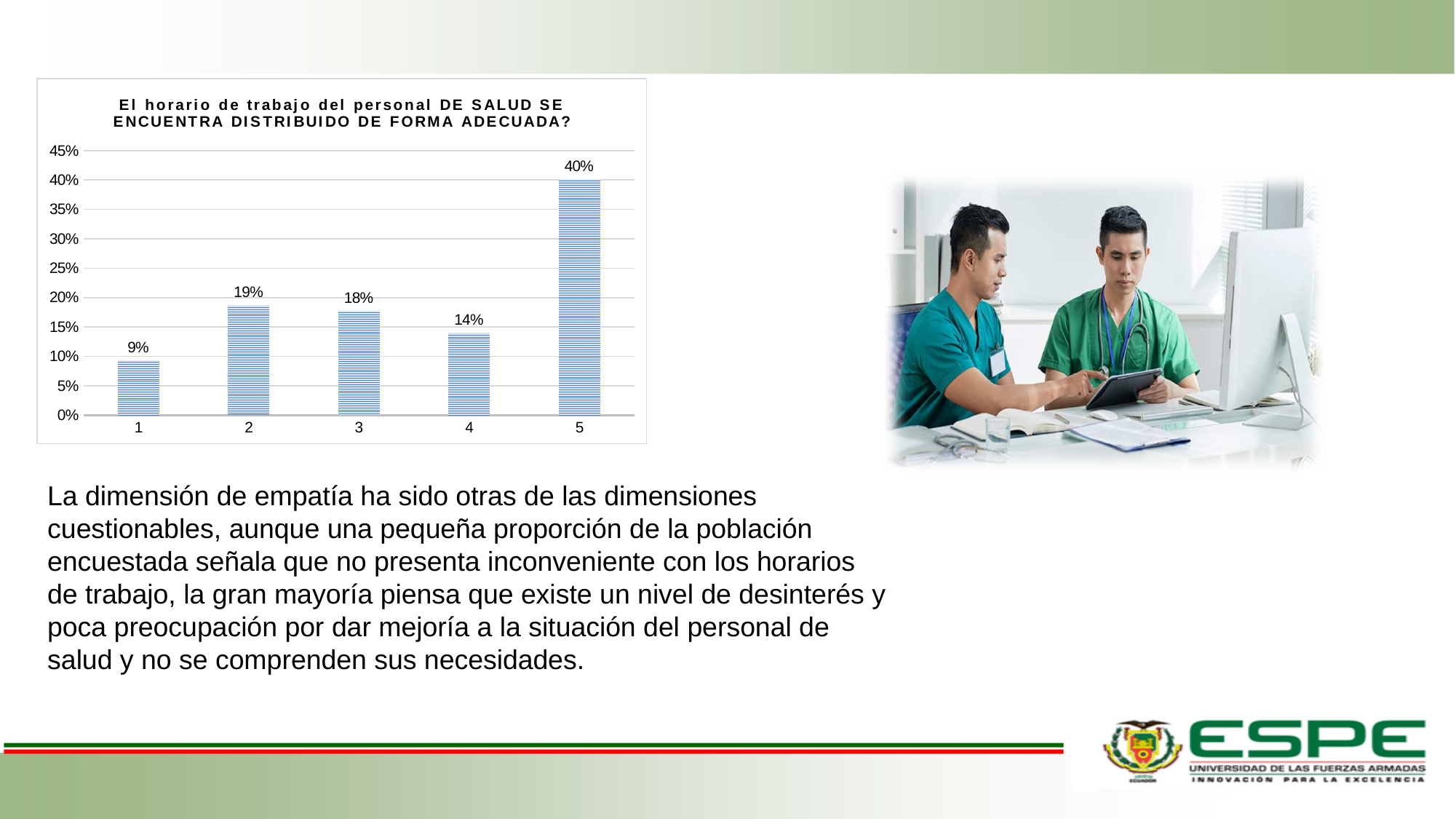
Which is larger, the value for category 2 or the value for category 4? 2 What is the title of the chart? El horario de trabajo del personal DE SALUD SE ENCUENTRA DISTRIBUIDO DE FORMA ADECUADA? What is the value for category 5? 40% Which category has the lowest value? 1 What kind of chart is shown on the slide? bar chart What is the difference between the values for category 5 and category 2? 21% Which category has the highest value? 5 What is the value for category 1? 9% What is the value for category 3? 18% Is the value for category 5 greater or less than 35%? greater What is the difference between the values for category 4 and category 1? 5% How many categories are shown on the x axis? 5